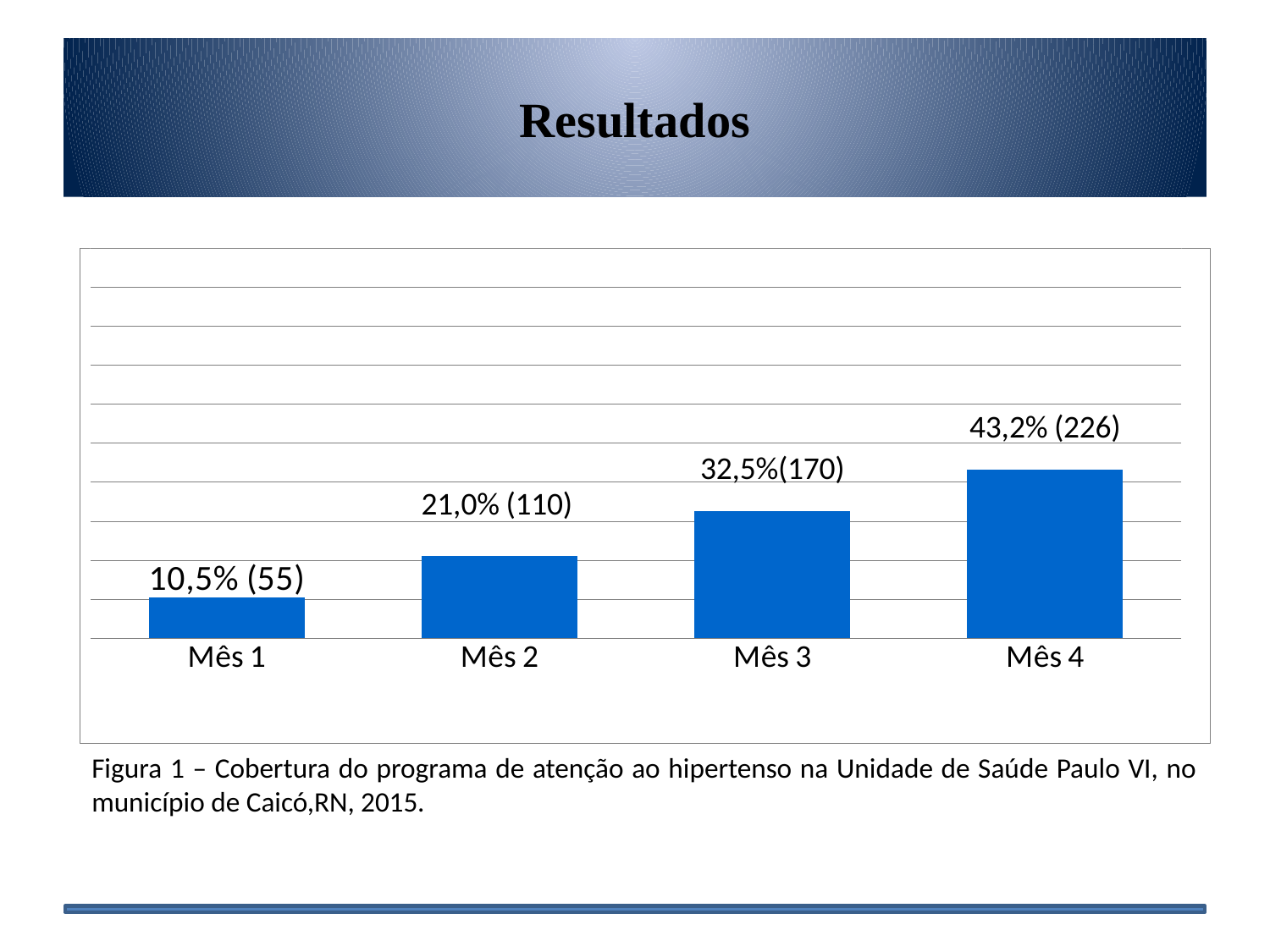
Which is larger, the value for Mês 2 or the value for Mês 3? Mês 3 What is the data label for Mês 2? 21,0% (110) Which month has the lowest value? Mês 1 What is the data label for Mês 3? 32,5%(170) What is the data label for Mês 1? 10,5% (55) Which month has the highest value? Mês 4 How many months are shown on the chart? 4 What is the difference in the number of people between Mês 4 and Mês 1? 171 What is the difference in percentage points between Mês 3 and Mês 2? 11,5 What is the data label for Mês 4? 43,2% (226) Do the values rise or fall from Mês 1 to Mês 4? Rise What kind of chart is shown on the slide? Bar chart